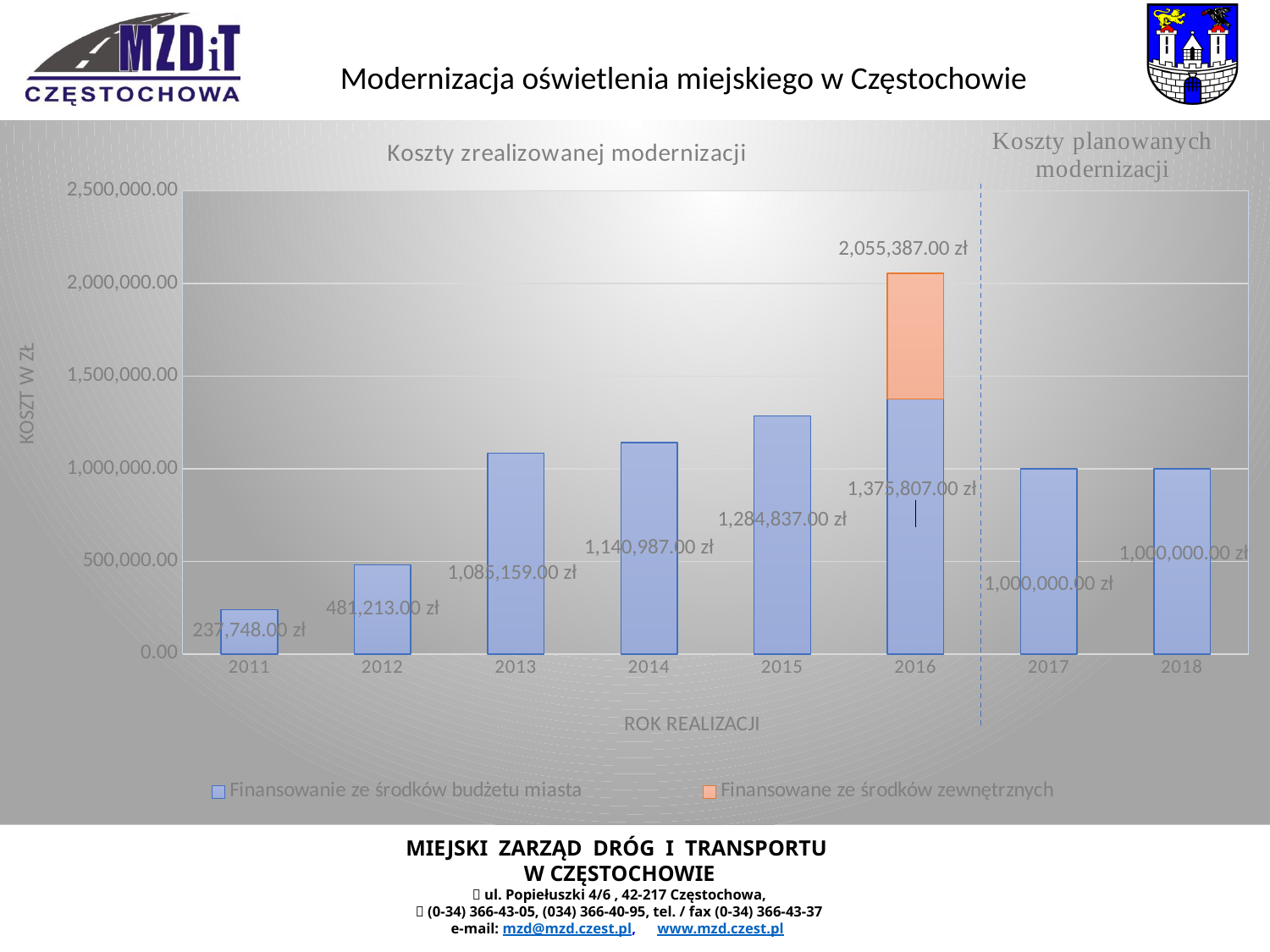
What type of chart is shown on the slide? bar chart What is the value of the 'Finansowanie ze środków budżetu miasta' segment for 2016? 1,375,807.00 zł Do the costs rise or fall from 2011 to 2015? rise Which year has the lowest cost? 2011 Which year has the tallest bar? 2016 What is the cost shown for 2014? 1,140,987.00 zł What is the planned cost shown for 2017? 1,000,000.00 zł How many years are shown on the x axis? 8 How many series does the legend list? 2 Which year has the higher cost, 2013 or 2015? 2015 What is the cost shown for 2011? 237,748.00 zł What is the difference between the costs for 2012 and 2011? 243,465.00 zł